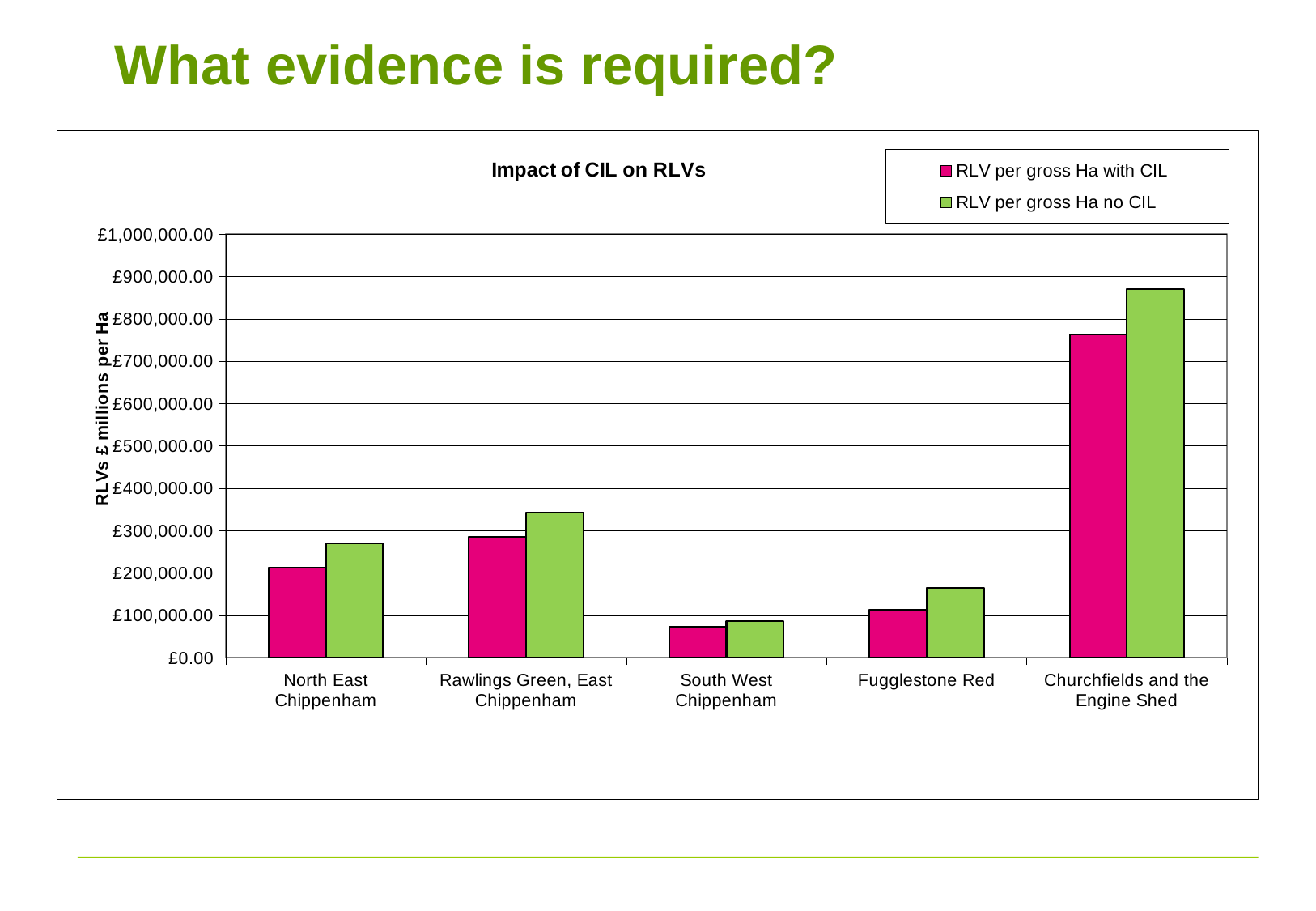
Is the RLV per gross Ha with CIL for Churchfields and the Engine Shed greater or less than £700,000.00? greater Is the RLV per gross Ha no CIL for Rawlings Green, East Chippenham greater or less than £300,000.00? greater Which site has the lowest RLV per gross Ha with CIL? South West Chippenham Which site has the highest RLV per gross Ha no CIL? Churchfields and the Engine Shed What kind of chart is shown on the slide? bar chart Is the RLV per gross Ha no CIL for Churchfields and the Engine Shed greater or less than £800,000.00? greater What is the title of the chart? Impact of CIL on RLVs How many series does the legend list? 2 How many site categories are shown on the x axis? 5 Which is larger: the RLV per gross Ha with CIL for North East Chippenham or the RLV per gross Ha no CIL for Fugglestone Red? RLV per gross Ha with CIL for North East Chippenham For Fugglestone Red, which is larger: RLV per gross Ha with CIL or RLV per gross Ha no CIL? RLV per gross Ha no CIL